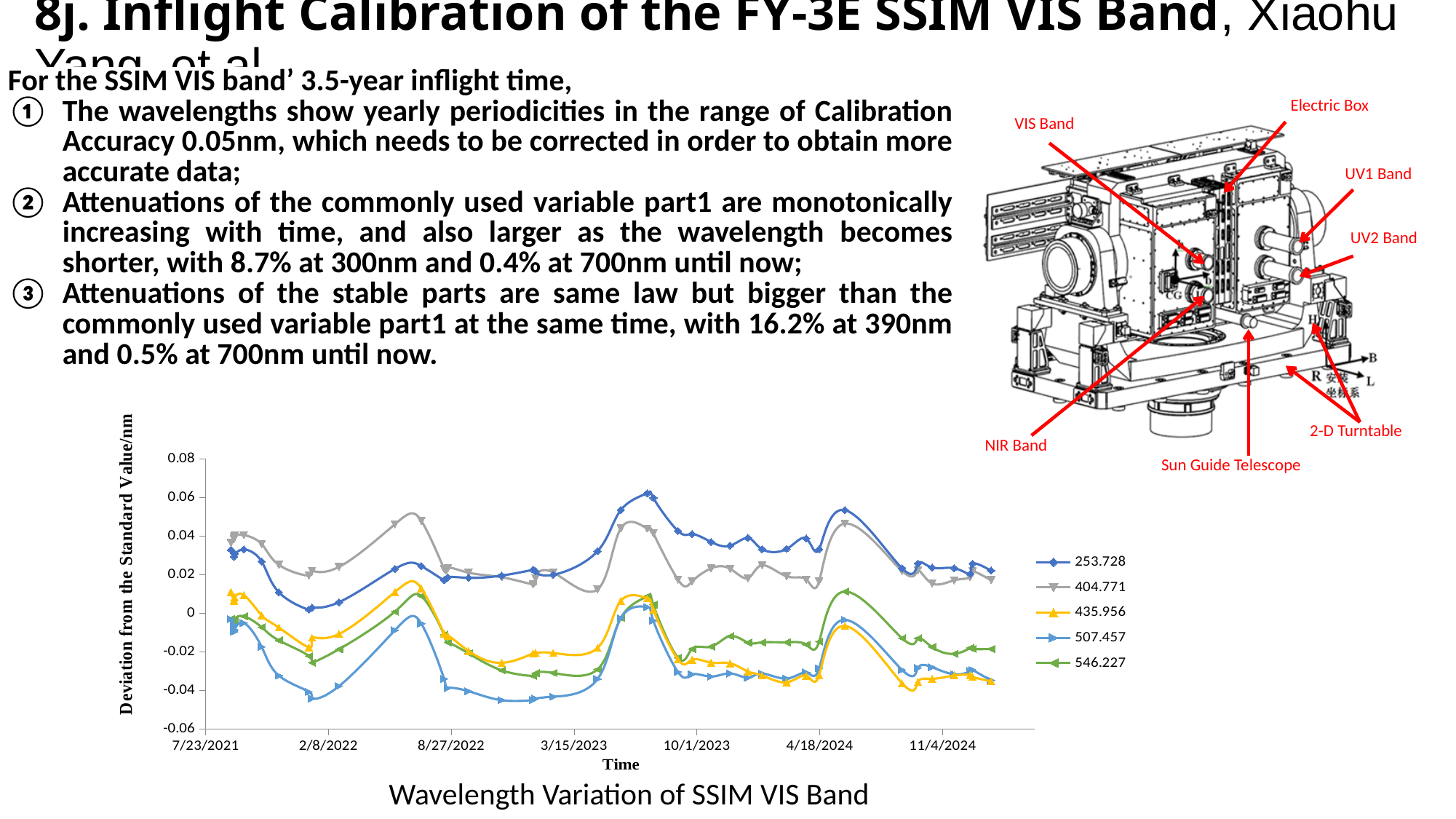
At 7/23/2021, which series has the larger value, 253.728 or 507.457? 253.728 Which series reaches the highest peak on the chart? 253.728 How many date labels are shown on the x axis of the chart? 7 Is the highest value of the 253.728 series greater or less than 0.04? greater Which series reaches the lowest value on the chart? 507.457 Is the value of the 404.771 series at 10/1/2023 greater or less than 0? greater What is the title of the chart? Wavelength Variation of SSIM VIS Band Is the lowest value of the 507.457 series greater or less than -0.04? less How many series does the legend of the chart list? 5 What kind of chart is shown on the slide? line chart What is the label of the y axis of the chart? Deviation from the Standard Value/nm Does the 253.728 series rise or fall between 7/23/2021 and 2/8/2022? fall